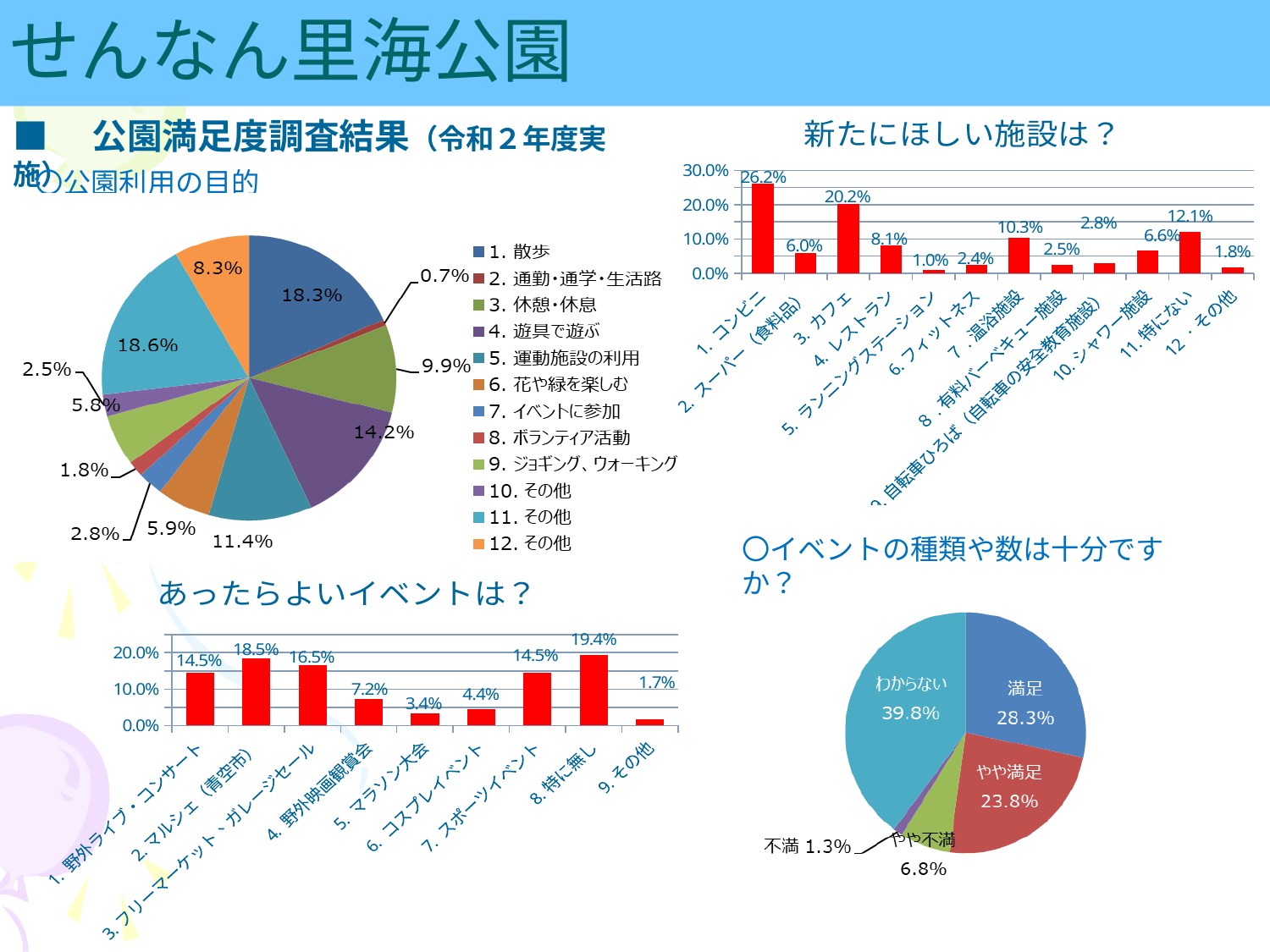
In the bar chart titled あったらよいイベントは？, which is larger, 2. マルシェ（青空市） or 3. フリーマーケット・ガレージセール? 2. マルシェ（青空市） In the bar chart titled あったらよいイベントは？, what is the value for 8. 特に無し? 19.4% In the pie chart titled 公園利用の目的, what is the share for 1. 散歩? 18.3% In the bar chart titled 新たにほしい施設は？, what is the difference between 3. カフェ and 7. 温浴施設? 9.9% In the bar chart titled 新たにほしい施設は？, which category has the lowest value? 5. ランニングステーション In the bar chart titled 新たにほしい施設は？, how many categories are shown? 12 In the bar chart titled あったらよいイベントは？, which category has the lowest value? 9. その他 In the bar chart titled 新たにほしい施設は？, what is the value for 1. コンビニ? 26.2% In the bar chart titled 新たにほしい施設は？, which category has the highest value? 1. コンビニ In the pie chart titled イベントの種類や数は十分ですか？, what is the combined share of 満足 and やや満足? 52.1% What kind of chart is used for 新たにほしい施設は？? bar chart In the pie chart titled イベントの種類や数は十分ですか？, what is the share for わからない? 39.8%